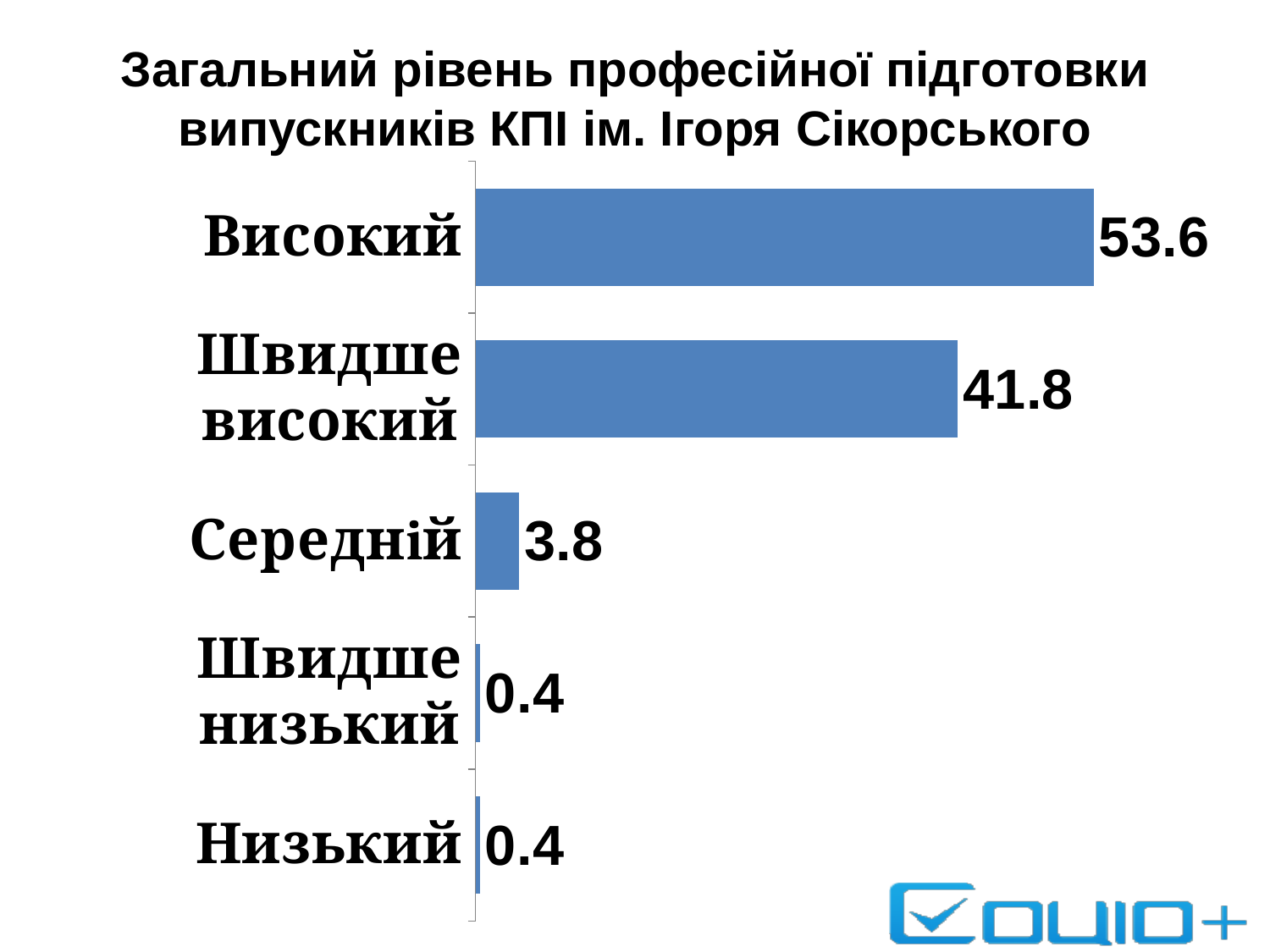
What is the total of the values for Швидше низький and Низький? 0.8 What is the difference between the values for Швидше високий and Середній? 38 What is the difference between the values for Високий and Швидше високий? 11.8 What is the value for Високий? 53.6 Which category has the highest value? Високий What is the value for Швидше низький? 0.4 Which is larger, the value for Середній or the value for Низький? Середній How many categories are shown in the chart? 5 What is the title of the chart? Загальний рівень професійної підготовки випускників КПІ ім. Ігоря Сікорського What kind of chart is shown on the slide? Bar chart What is the value for Середній? 3.8 What is the value for Швидше високий? 41.8